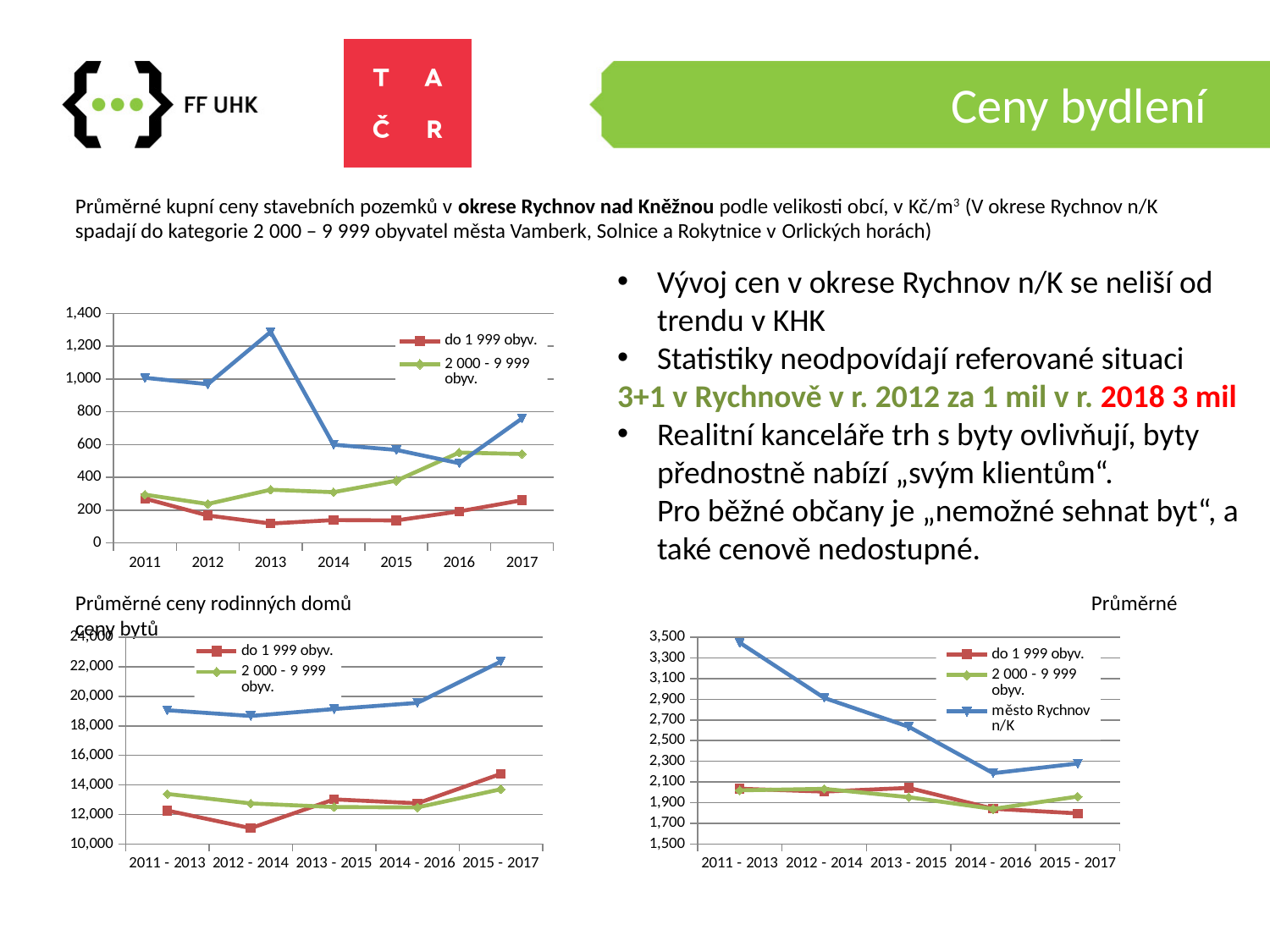
In the top-left chart (building plots, 2011–2017), which series has the higher value in 2011: 'do 1 999 obyv.' or '2 000 - 9 999 obyv.'? 2 000 - 9 999 obyv. In the top-left chart (building plots, 2011–2017), in which year does the blue line reach its highest value? 2013 In the chart 'Průměrné ceny rodinných domů' (bottom-left), is the value for 'do 1 999 obyv.' in 2012 - 2014 greater or less than 12,000? less In the top-left chart (building plots, 2011–2017), how many years are shown on the x axis? 7 In the chart 'Průměrné ceny rodinných domů' (bottom-left), in which period does the blue line reach its highest value? 2015 - 2017 In the top-left chart (building plots, 2011–2017), in which year is the value for 'do 1 999 obyv.' lowest? 2013 In the chart 'Průměrné ceny bytů' (bottom-right), how many series does the legend list? 3 In the chart 'Průměrné ceny bytů' (bottom-right), does the value for 'město Rychnov n/K' rise or fall from 2011 - 2013 to 2014 - 2016? fall In the chart 'Průměrné ceny bytů' (bottom-right), is the value for 'město Rychnov n/K' in 2011 - 2013 greater or less than 3,300? greater What type of chart is the top-left chart showing prices of building plots from 2011 to 2017? line chart In the top-left chart (building plots, 2011–2017), is the value of the blue line in 2013 greater or less than 1,200? greater